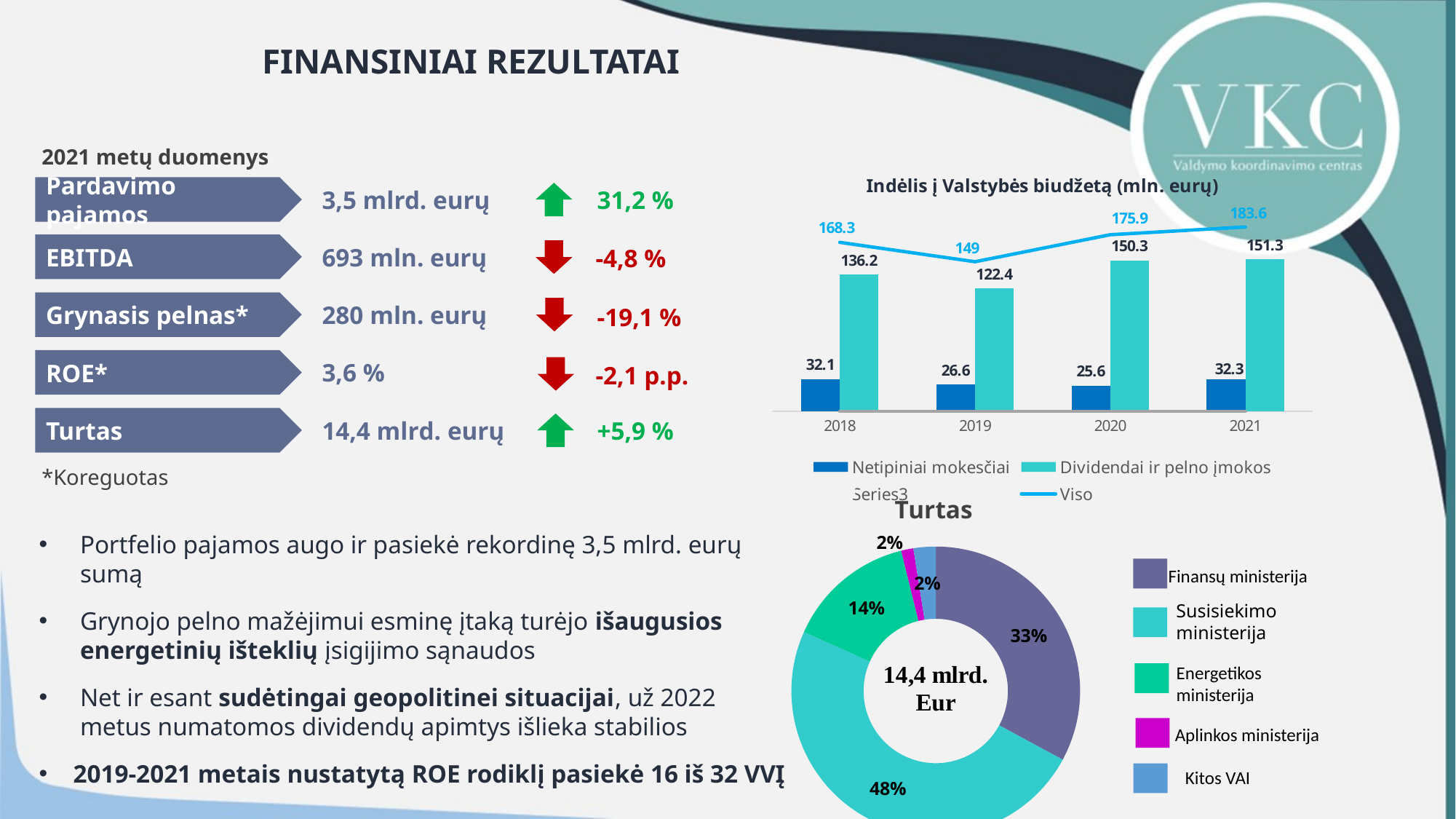
How many years are shown on the x axis of the chart 'Indėlis į Valstybės biudžetą (mln. eurų)'? 4 In the chart 'Indėlis į Valstybės biudžetą (mln. eurų)', which year has the lowest Dividendai ir pelno įmokos value? 2019 In the 'Turtas' donut chart, which category has the largest share? Susisiekimo ministerija What total value is printed in the centre of the 'Turtas' donut chart? 14,4 mlrd. Eur In the chart 'Indėlis į Valstybės biudžetą (mln. eurų)', what is the value of Dividendai ir pelno įmokos for 2021? 151.3 In the chart 'Indėlis į Valstybės biudžetą (mln. eurų)', what is the difference between the Viso values for 2021 and 2018? 15.3 In the chart 'Indėlis į Valstybės biudžetą (mln. eurų)', which year has the highest Viso value? 2021 In the 'Turtas' donut chart, what is the difference between the shares of Finansų ministerija and Energetikos ministerija? 19% In the chart 'Indėlis į Valstybės biudžetą (mln. eurų)', is the Netipiniai mokesčiai value larger in 2018 or in 2021? 2021 In the 'Turtas' donut chart, what share does Susisiekimo ministerija have? 48% In the chart 'Indėlis į Valstybės biudžetą (mln. eurų)', what is the value of Netipiniai mokesčiai for 2019? 26.6 In the chart 'Indėlis į Valstybės biudžetą (mln. eurų)', what is the Viso value for 2020? 175.9